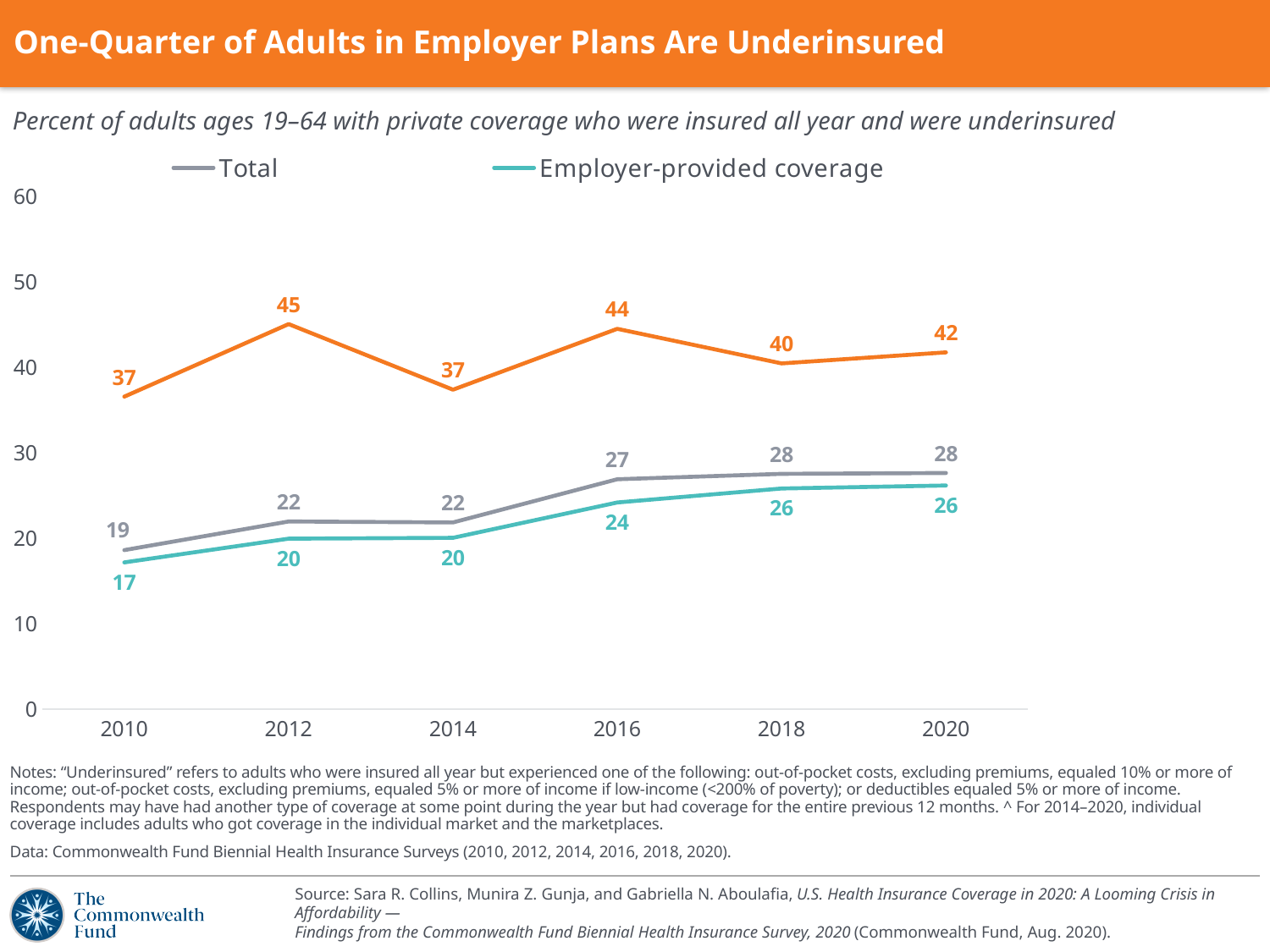
What is the value for Total in 2018? 28 Is the value for Employer-provided coverage in 2018 greater or less than 30? less Which is larger in 2016, the Total value or the Employer-provided coverage value? Total By how much did the Total value increase from 2010 to 2020? 9 What is the value for Employer-provided coverage in 2020? 26 How many years are shown on the x axis? 6 What is the difference between the Total value and the Employer-provided coverage value in 2012? 2 How many series does the legend list? 2 What is the value for Employer-provided coverage in 2016? 24 What kind of chart is shown on the slide? line chart What is the value for Total in 2010? 19 In which year is the Employer-provided coverage line at its lowest? 2010